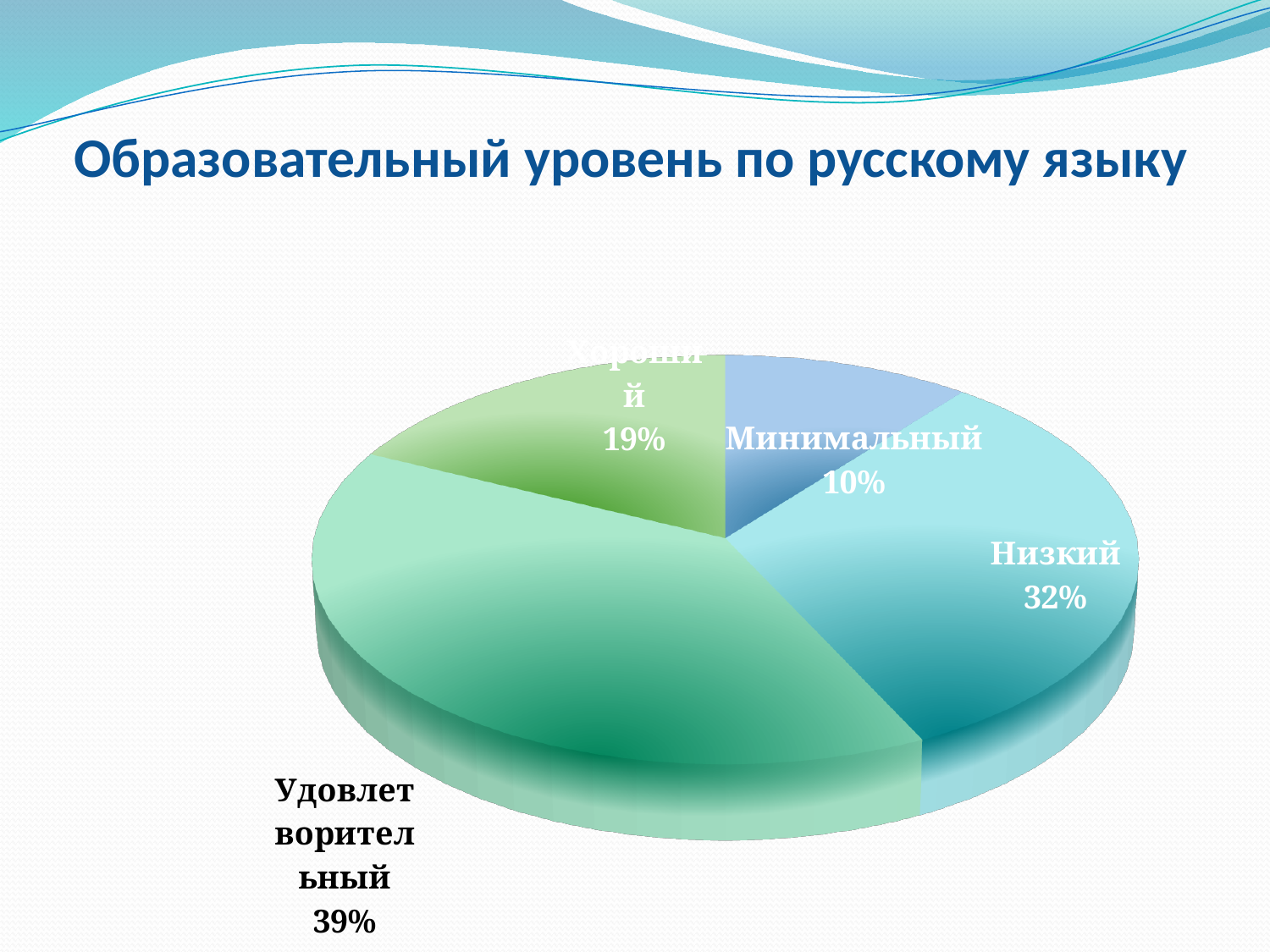
How many slices does the pie chart have? 4 What share of the pie is labelled Минимальный? 10% What is the title of the chart on the slide? Образовательный уровень по русскому языку What share of the pie is labelled Хороший? 19% What is the difference in percentage points between Низкий and Хороший? 13 Which is larger, the share for Хороший or the share for Минимальный? Хороший What is the difference in percentage points between Удовлетворительный and Низкий? 7 What share of the pie is labelled Низкий? 32% Which category has the largest share of the pie? Удовлетворительный What kind of chart is shown on the slide? pie chart Which category has the smallest share of the pie? Минимальный